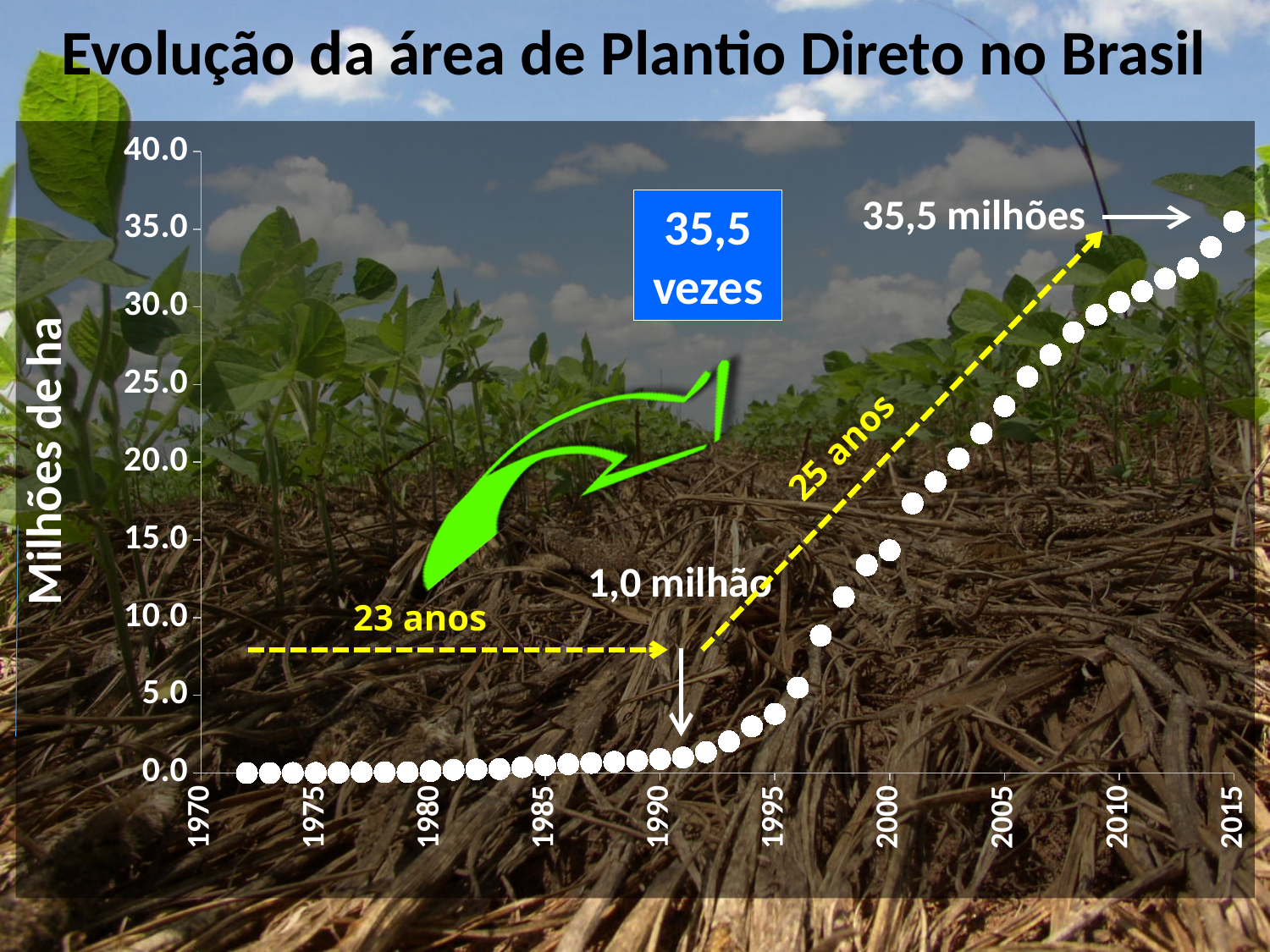
Is the value for 2005 greater or less than 20.0? greater Is the value for 1980 greater or less than 5.0? less What is the highest value shown on the vertical axis? 40.0 Is the value for 2000 greater or less than 10.0? greater According to the annotation, what is the area of Plantio Direto in 2015? 35,5 milhões What is the label of the vertical axis? Milhões de ha What kind of chart is shown on the slide? scatter chart Do the plotted values rise or fall from 1970 to 2015? rise Which year has the larger value, 2000 or 2010? 2010 Which year has the highest plotted value? 2015 What is the title of the chart? Evolução da área de Plantio Direto no Brasil